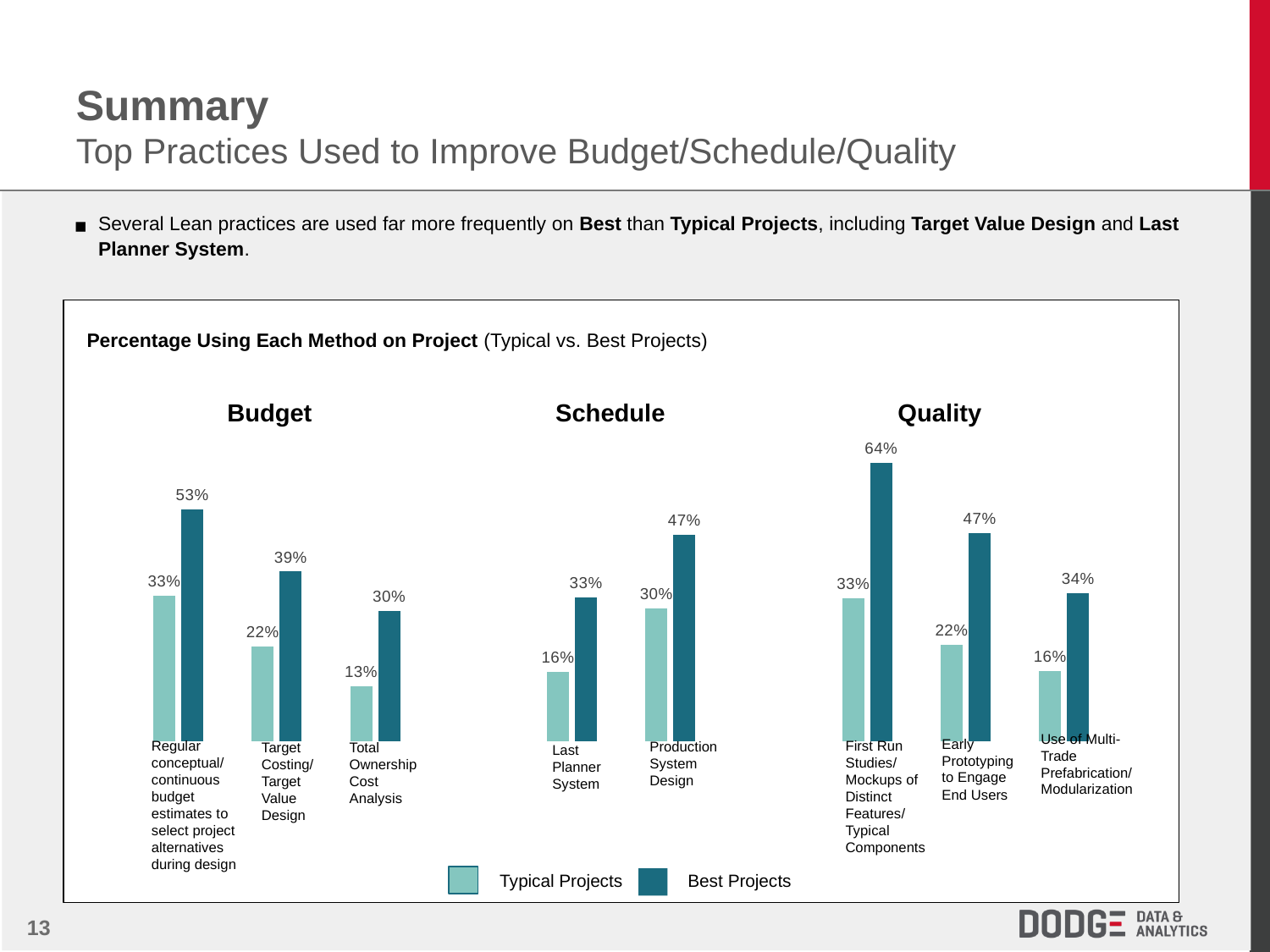
What type of chart is used for the Quality section? Bar chart Which series is shown in the darker teal colour in the legend? Best Projects In the Quality chart, what percentage of Best Projects use First Run Studies/Mockups of Distinct Features/Typical Components? 64% In the Schedule chart, what percentage of Typical Projects use the Last Planner System? 16% In the Schedule chart, what is the difference between Best Projects and Typical Projects for Production System Design? 17% In the Budget chart, which practice has the lowest value for Typical Projects? Total Ownership Cost Analysis In the Quality chart, which practice has the highest value for Best Projects? First Run Studies/Mockups of Distinct Features/Typical Components How many series does the legend list? 2 In the Budget chart, what percentage of Best Projects use Target Costing/Target Value Design? 39% How many practices are shown in the Schedule chart? 2 In the Quality chart, what is the difference between Best Projects and Typical Projects for Early Prototyping to Engage End Users? 25% In the Budget chart, which is larger: the Best Projects value for Total Ownership Cost Analysis or the Typical Projects value for Regular conceptual/continuous budget estimates? Typical Projects value for Regular conceptual/continuous budget estimates